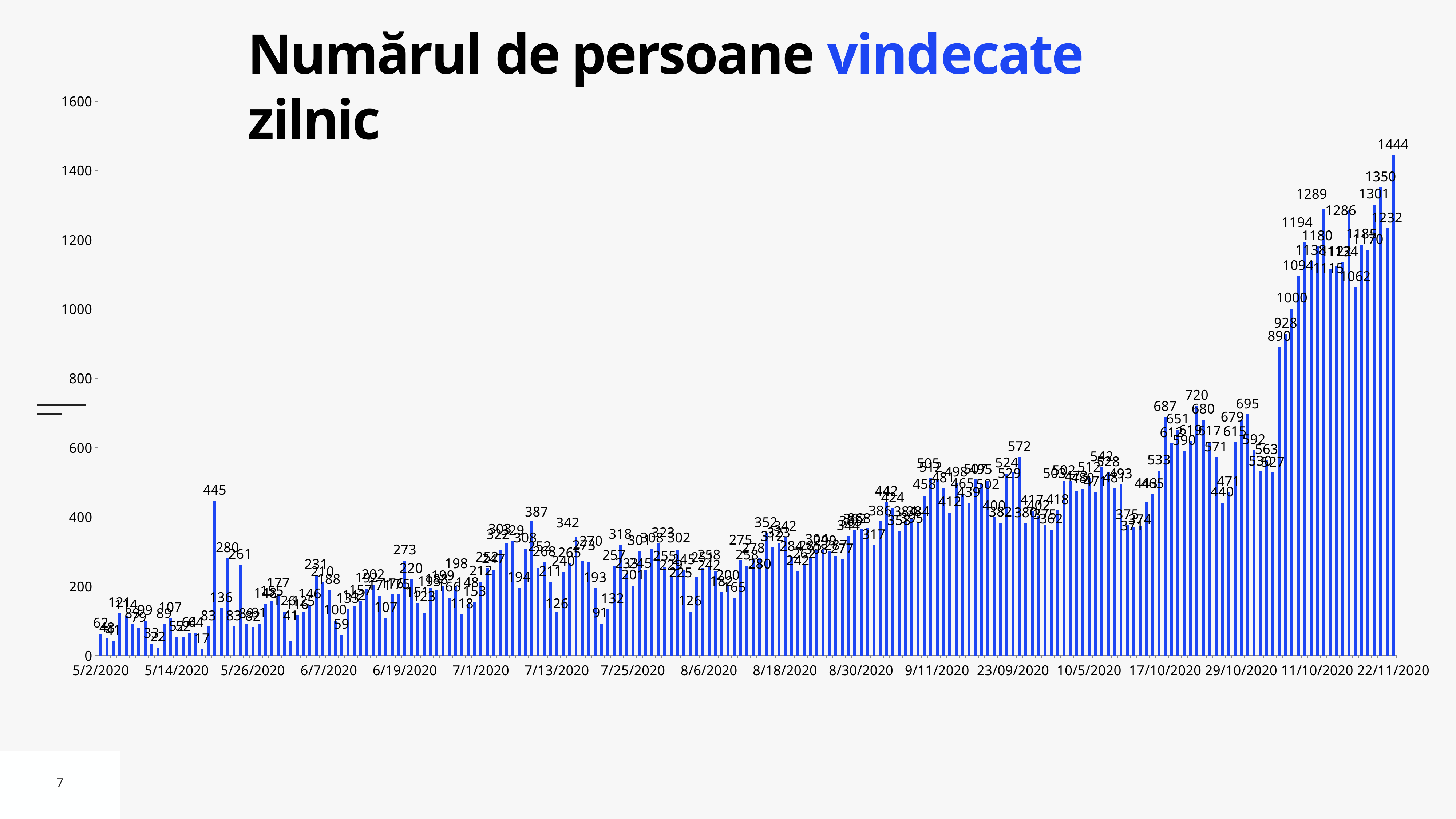
What colour are the bars in the chart? blue Is the value for 22/11/2020 greater or less than 1400? greater What is the title of the chart? Numărul de persoane vindecate zilnic What is the lowest value labelled in the chart? 17 Overall, do the values rise or fall from left to right along the x axis? rise What is the difference between the two highest labelled values, 1444 and 1350? 94 Which is larger: the value labelled 1444 or the value labelled 445? 1444 What is the value for 22/11/2020? 1444 What is the highest value shown in the chart? 1444 On which date does the chart reach its highest value? 22/11/2020 What kind of chart is shown on the slide? bar chart Is the value for 5/2/2020 greater or less than 200? less